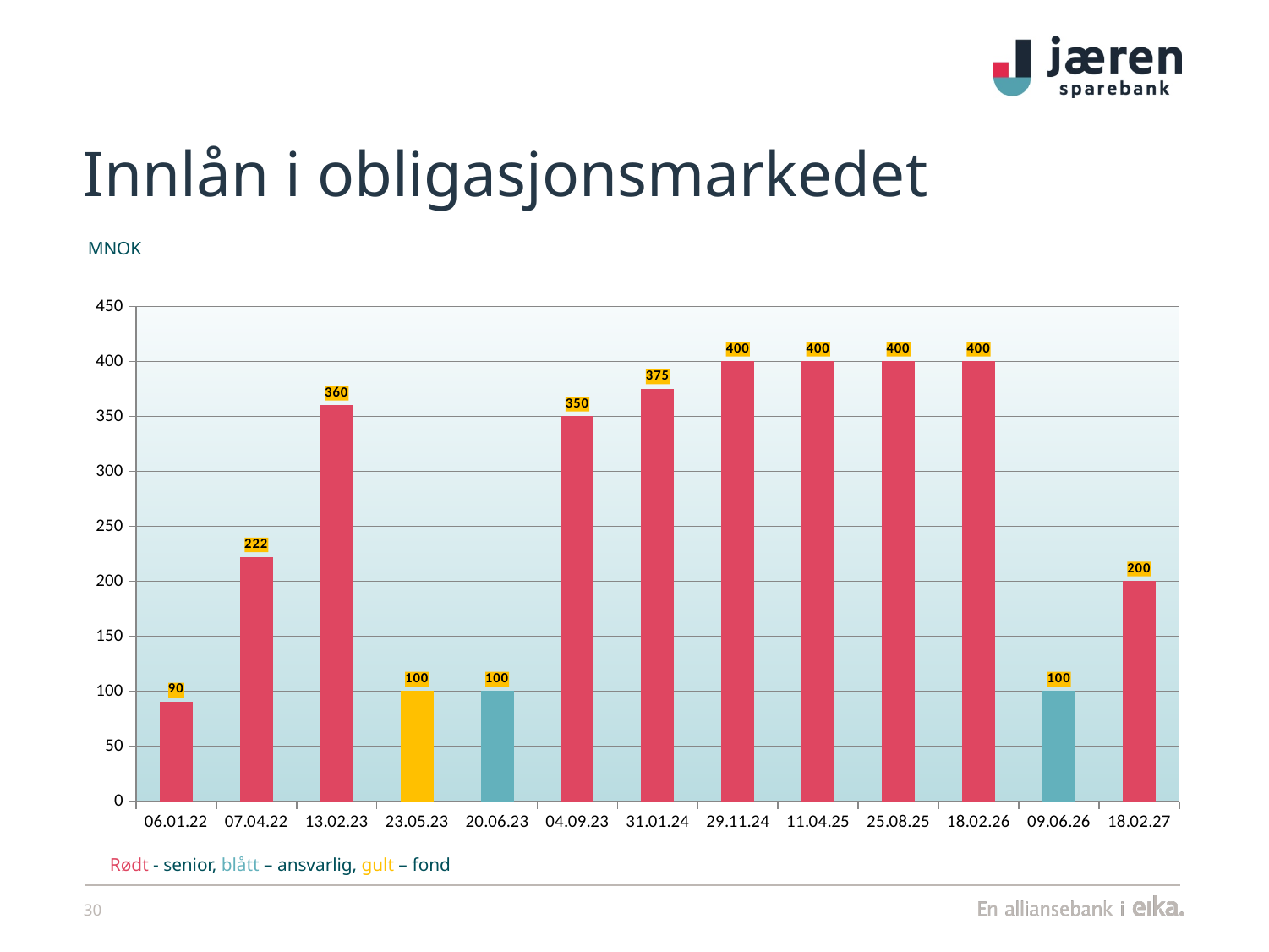
Which date has the lowest value? 06.01.22 What is the highest value shown in the chart? 400 According to the colour key, what do the yellow bars represent? fond What is the title of the chart? Innlån i obligasjonsmarkedet Which is larger, the value for 07.04.22 or the value for 18.02.27? 07.04.22 How many bars are shown in the chart? 13 What is the value for 31.01.24? 375 What is the value for 18.02.27? 200 What is the difference between the values for 13.02.23 and 04.09.23? 10 What is the value for 13.02.23? 360 What kind of chart is shown on the slide? Bar chart What is the value for 07.04.22? 222